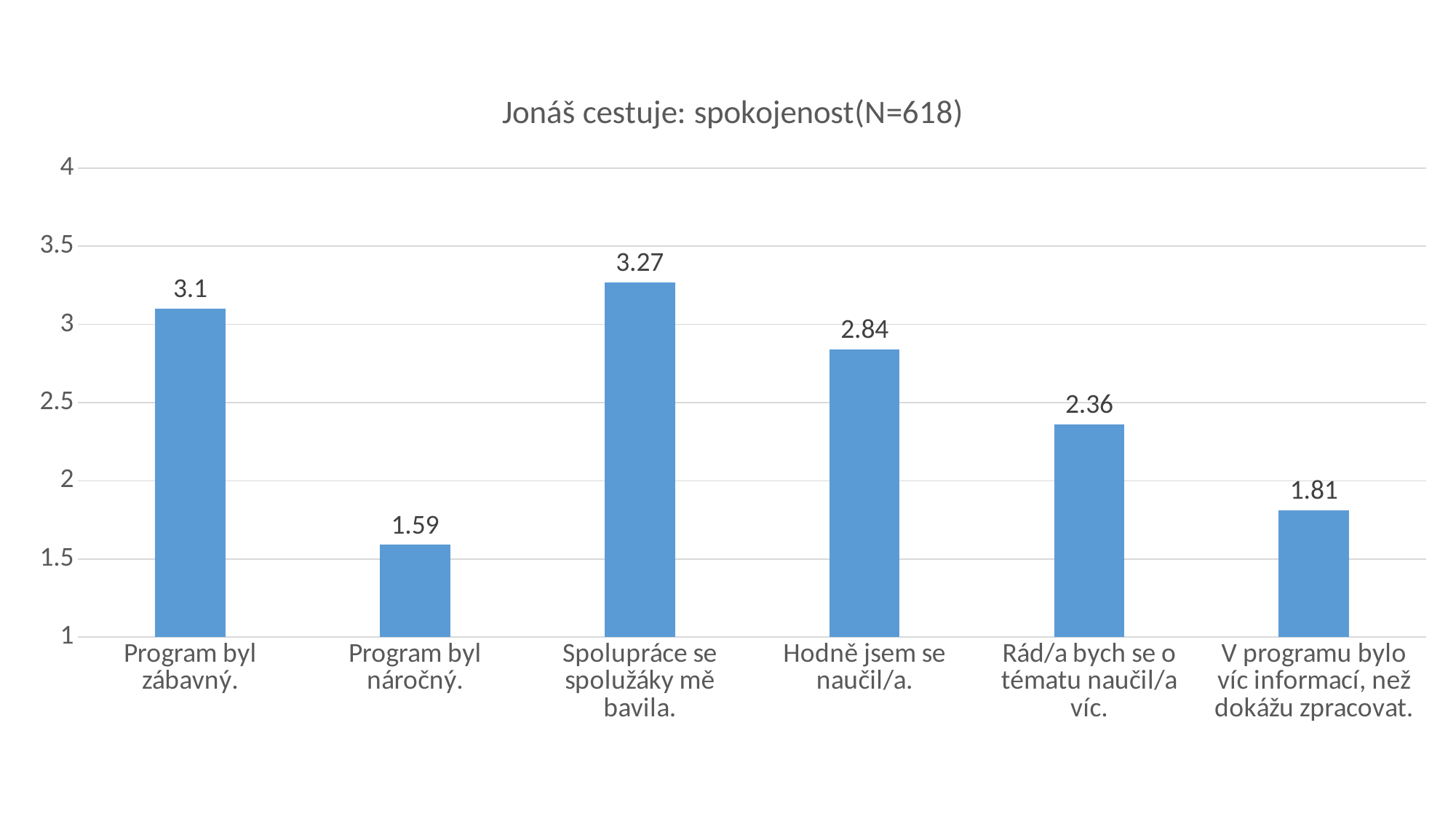
What is the difference between the values for "Spolupráce se spolužáky mě bavila." and "Hodně jsem se naučil/a."? 0.43 What is the value for "Program byl náročný."? 1.59 What kind of chart is shown on the slide? bar chart What is the value for "V programu bylo víc informací, než dokážu zpracovat."? 1.81 What is the value for "Program byl zábavný."? 3.1 What is the difference between the values for "Program byl zábavný." and "Program byl náročný."? 1.51 Which is larger: the value for "Rád/a bych se o tématu naučil/a víc." or the value for "V programu bylo víc informací, než dokážu zpracovat."? Rád/a bych se o tématu naučil/a víc. Which category has the highest value? Spolupráce se spolužáky mě bavila. Which category has the lowest value? Program byl náročný. Is the value for "Hodně jsem se naučil/a." greater or less than 3? less How many categories are shown on the x axis? 6 What is the title of the chart? Jonáš cestuje: spokojenost(N=618)